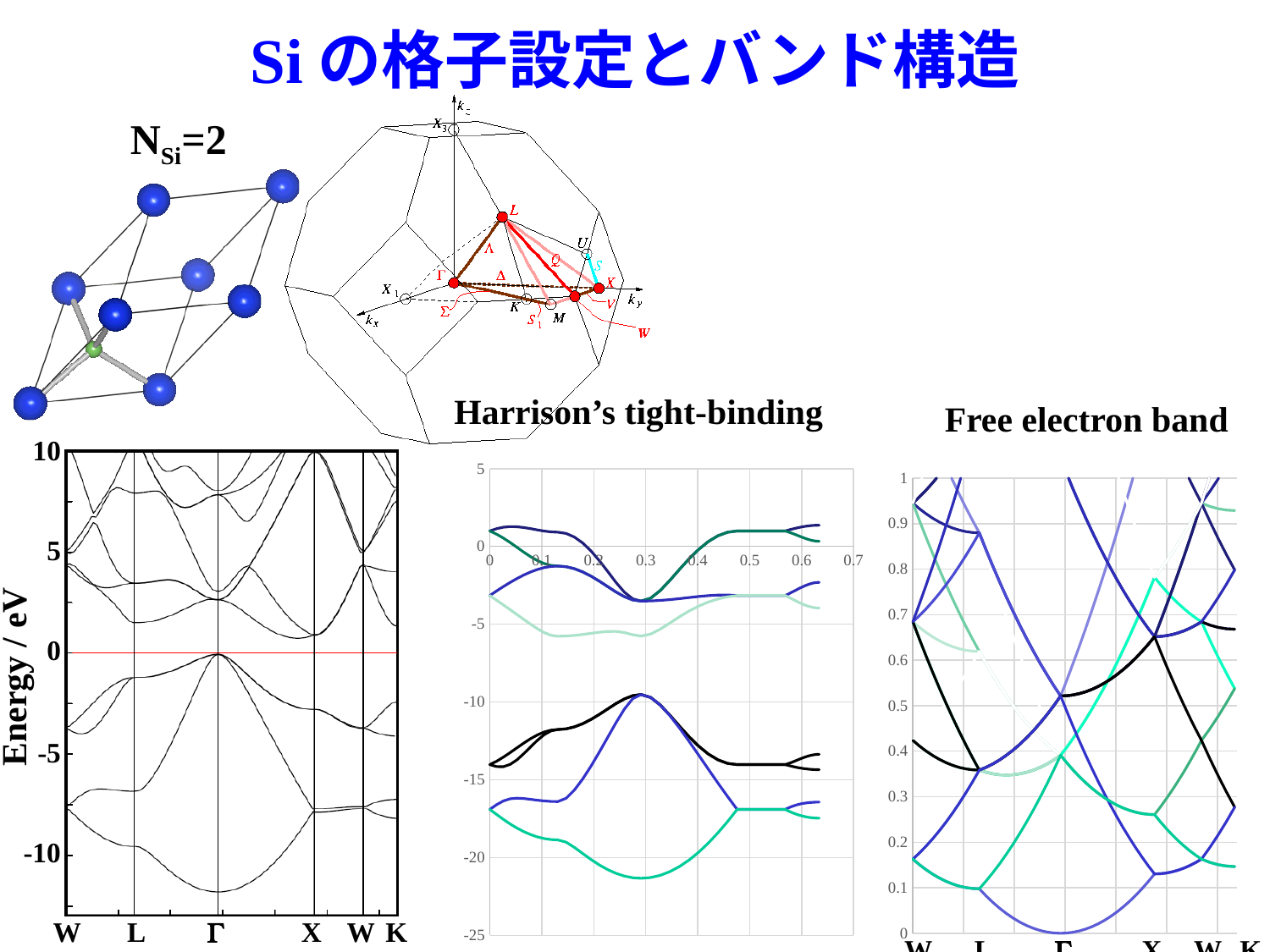
What kind of chart is the left chart with the y-axis labelled Energy / eV? line chart On the Harrison's tight-binding chart, is the minimum of the lowest (green) band near x = 0.3 greater or less than -20? less On the Harrison's tight-binding chart, what is the lowest value shown on the y axis? -25 On the Free electron band chart, what is the highest value shown on the y axis? 1 What is the title of the middle chart? Harrison's tight-binding On the left band-structure chart, how many k-point labels are shown along the x axis? 6 What kind of chart is the Free electron band chart on the right? line chart On the left band-structure chart, at what energy value is the red horizontal line drawn? 0 On the left band-structure chart, what is the y-axis label? Energy / eV On the Harrison's tight-binding chart, what is the largest tick value shown on the x axis? 0.7 On the Free electron band chart, is the value of the lowest band at Γ greater or less than 0.1? less On the left band-structure chart, is the minimum of the lowest band at Γ greater or less than -10? less